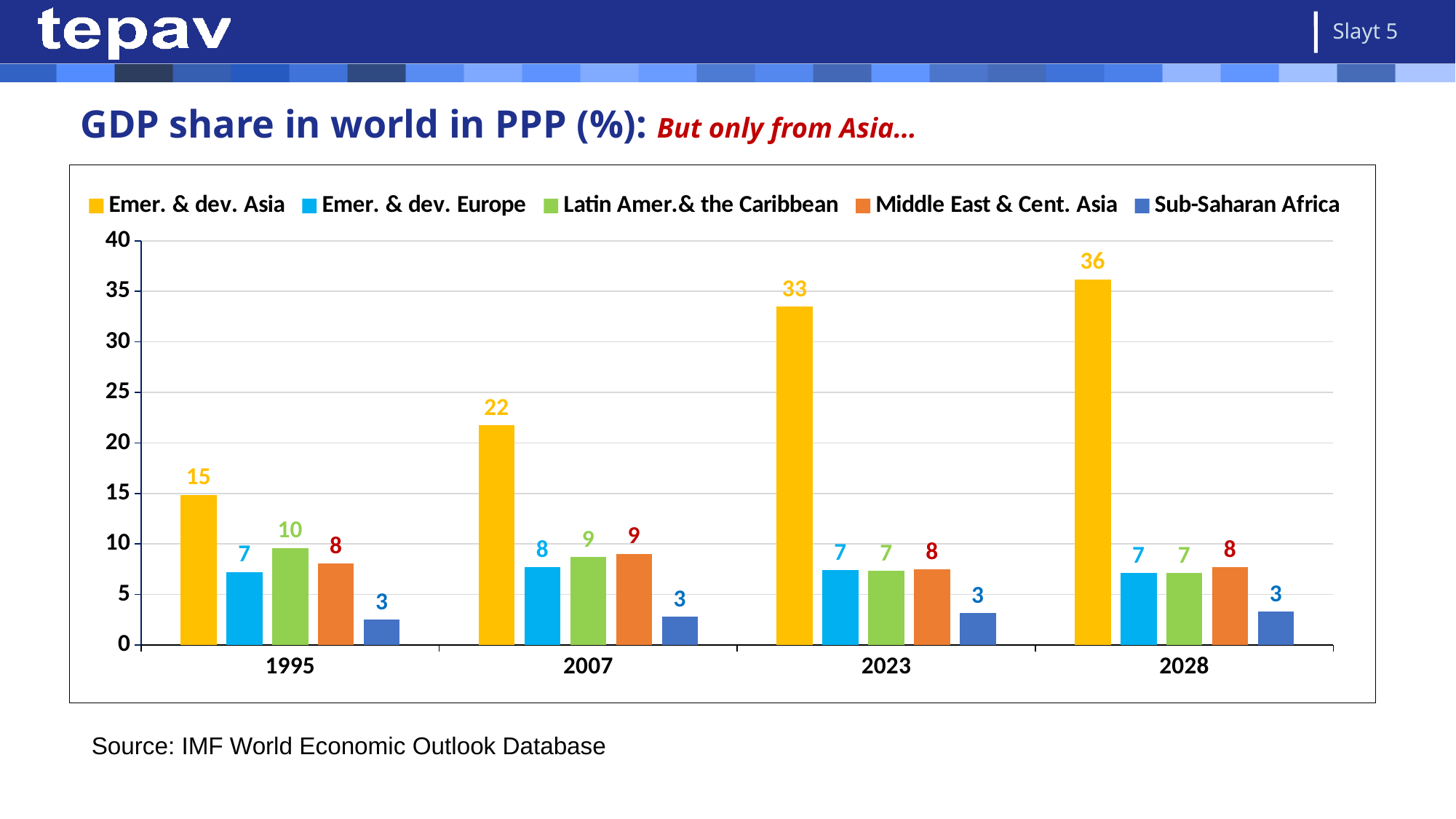
What is the value for Sub-Saharan Africa in 2028? 3 How many series does the legend list? 5 Does the value for Emer. & dev. Asia in 2007 rise or fall compared with 1995? rise Which is larger: Latin Amer.& the Caribbean in 1995 or Middle East & Cent. Asia in 1995? Latin Amer.& the Caribbean What kind of chart is shown on the slide? bar chart What is the value for Latin Amer.& the Caribbean in 1995? 10 How many year categories are shown on the x axis? 4 What is the value for Middle East & Cent. Asia in 2007? 9 What is the value for Emer. & dev. Asia in 2023? 33 What is the difference between the Emer. & dev. Asia values in 2028 and 1995? 21 Which series has the lowest value in 1995? Sub-Saharan Africa Which series has the highest value in 2028? Emer. & dev. Asia